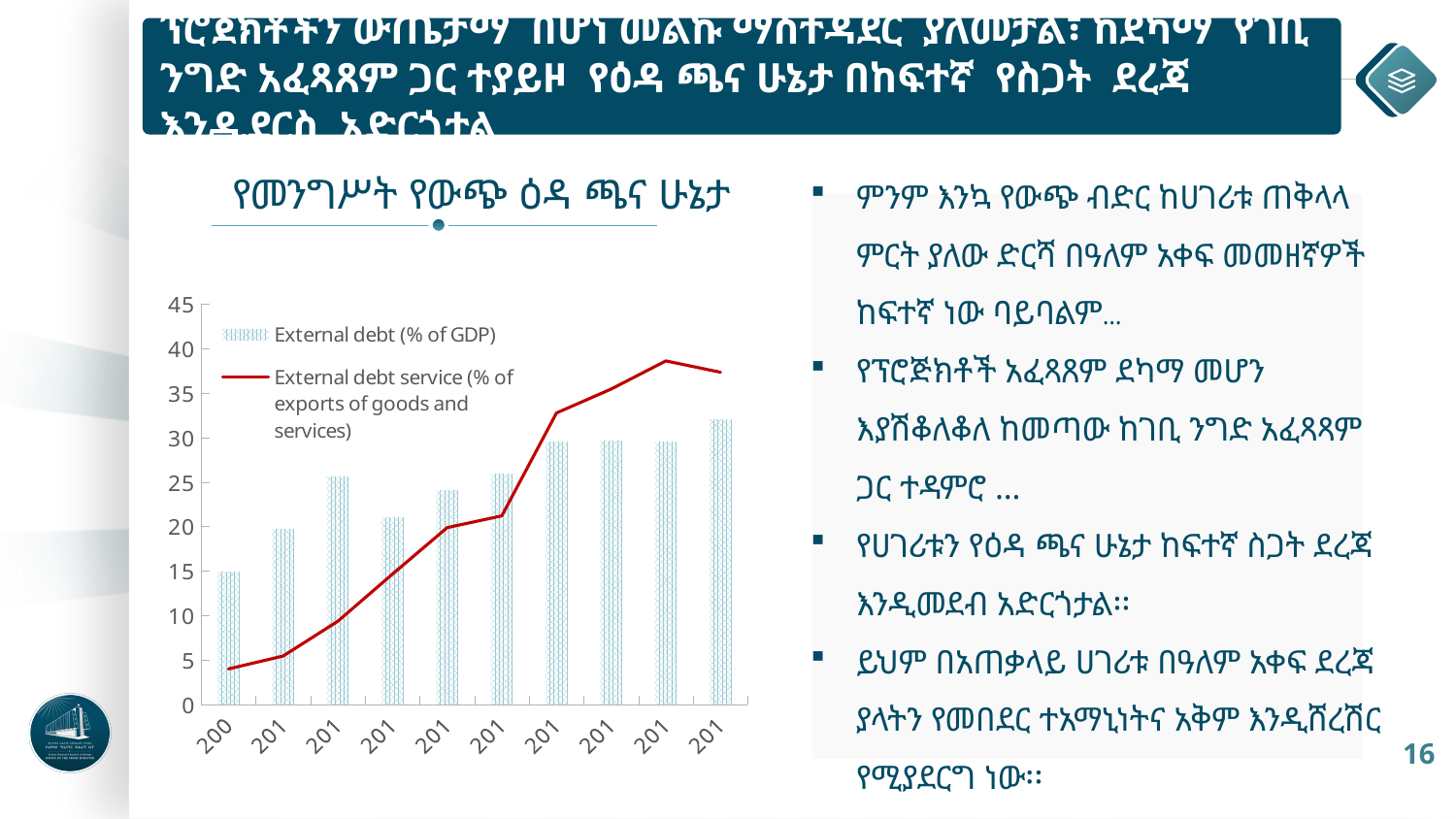
Does the External debt service line generally rise or fall from left to right? Rise Is the first point of the External debt service line greater or less than 5? less What are the two series named in the chart legend? External debt (% of GDP) and External debt service (% of exports of goods and services) Is the value of the leftmost External debt (% of GDP) bar greater or less than 10? greater How many series does the chart legend list? 2 Do the External debt (% of GDP) bars generally rise or fall from left to right? Rise Which bar is the shortest for External debt (% of GDP), the leftmost or the rightmost? The leftmost At the rightmost point, which is larger: the External debt (% of GDP) bar or the External debt service line? External debt service line How many bars are plotted for External debt (% of GDP)? 10 Which series is drawn as a line in the chart? External debt service (% of exports of goods and services) Which bar is the tallest for External debt (% of GDP), the leftmost or the rightmost? The rightmost What kind of chart is shown on the slide? A combination bar and line chart